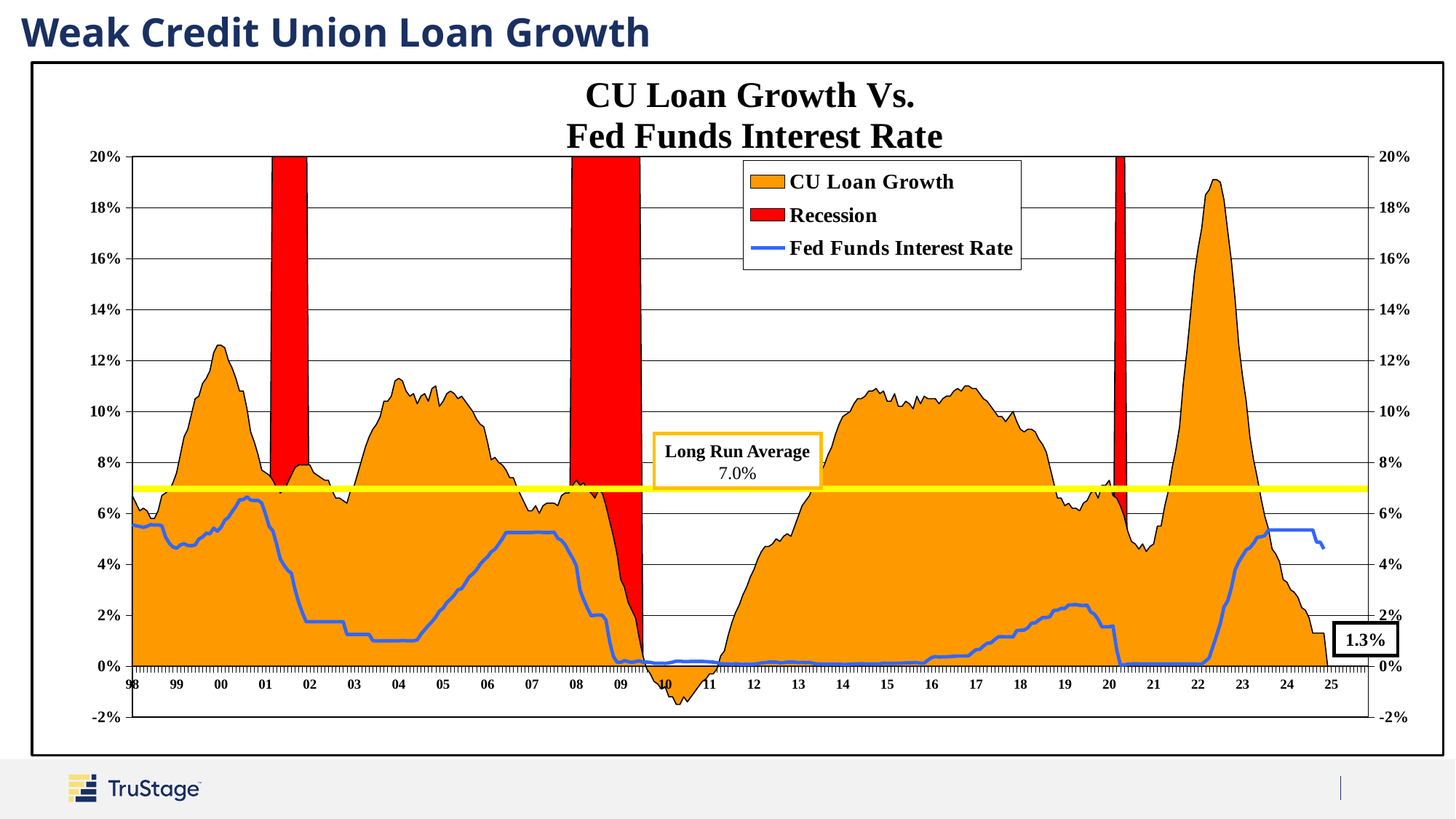
What kind of chart is used to plot CU Loan Growth? area chart In which year on the x axis does CU Loan Growth reach its highest peak? 22 How many recession bands are shaded on the chart? 3 From 22 to 25, does CU Loan Growth rise or fall? fall Is the Fed Funds Interest Rate around 10 greater or less than 2%? less Is the peak CU Loan Growth value around 22 greater or less than 18%? greater What is the Long Run Average value shown on the chart? 7.0% In which year on the x axis does CU Loan Growth reach its lowest point? 10 How many entries does the chart's legend list? 3 What is the title of the chart? CU Loan Growth Vs. Fed Funds Interest Rate Is the CU Loan Growth peak around 00 higher or lower than the peak around 22? lower What is the most recent CU Loan Growth value labeled at the right end of the chart? 1.3%